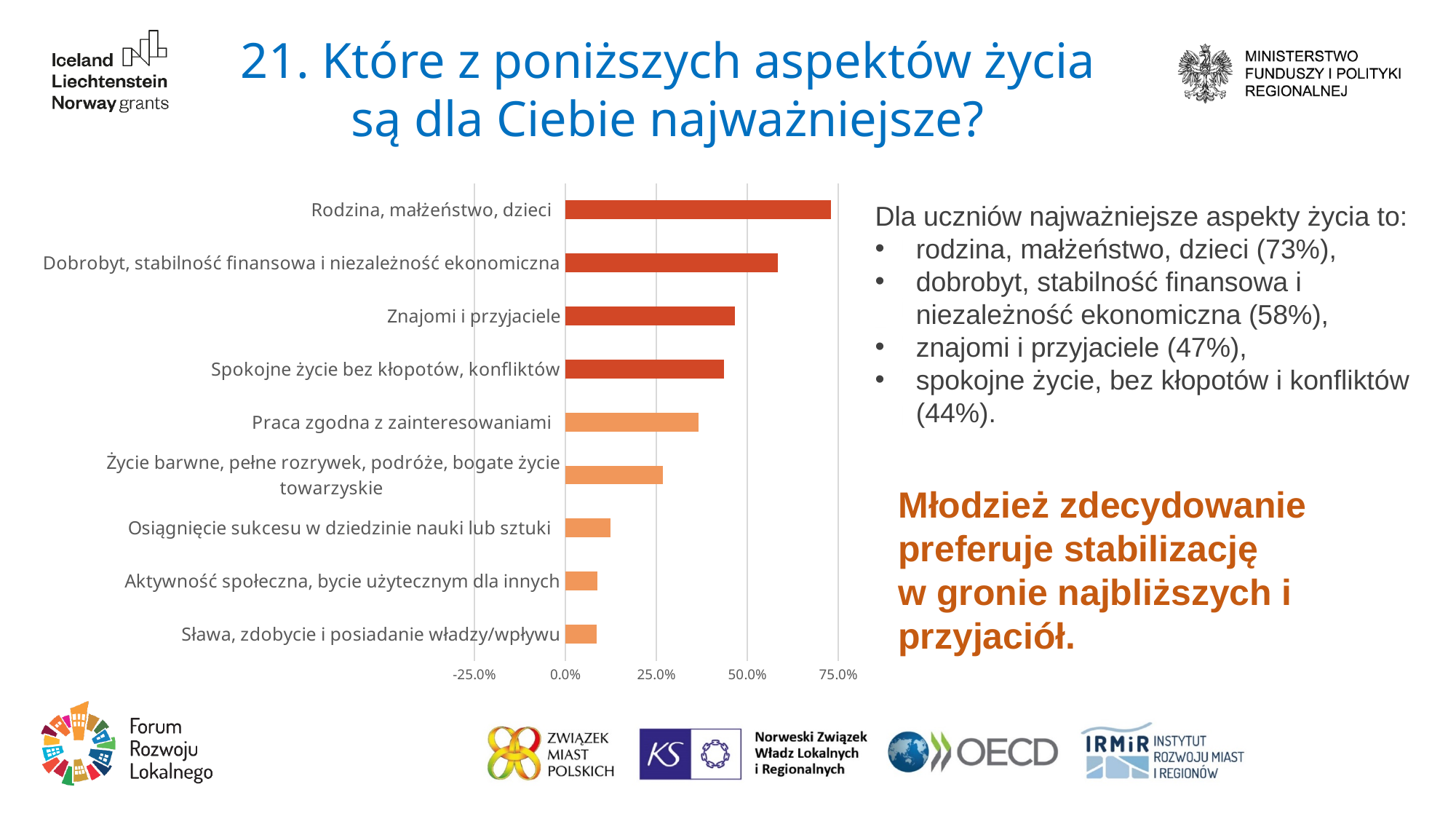
Is the value for Osiągnięcie sukcesu w dziedzinie nauki lub sztuki greater or less than 25.0%? less Is the value for Praca zgodna z zainteresowaniami greater or less than 25.0%? greater What is the highest tick label shown on the horizontal axis of the chart? 75.0% Which category has the highest value in the chart? Rodzina, małżeństwo, dzieci What is the difference between the values for Rodzina, małżeństwo, dzieci and Dobrobyt, stabilność finansowa i niezależność ekonomiczna? 15 percentage points How many categories are plotted in the chart? 9 Which is larger: the value for Praca zgodna z zainteresowaniami or the value for Życie barwne, pełne rozrywek, podróże, bogate życie towarzyskie? Praca zgodna z zainteresowaniami According to the slide, what is the value for Rodzina, małżeństwo, dzieci? 73% According to the slide, what is the value for Znajomi i przyjaciele? 47% According to the slide, what is the value for Dobrobyt, stabilność finansowa i niezależność ekonomiczna? 58% What kind of chart is shown on the slide? bar chart According to the slide, what is the value for Spokojne życie bez kłopotów, konfliktów? 44%